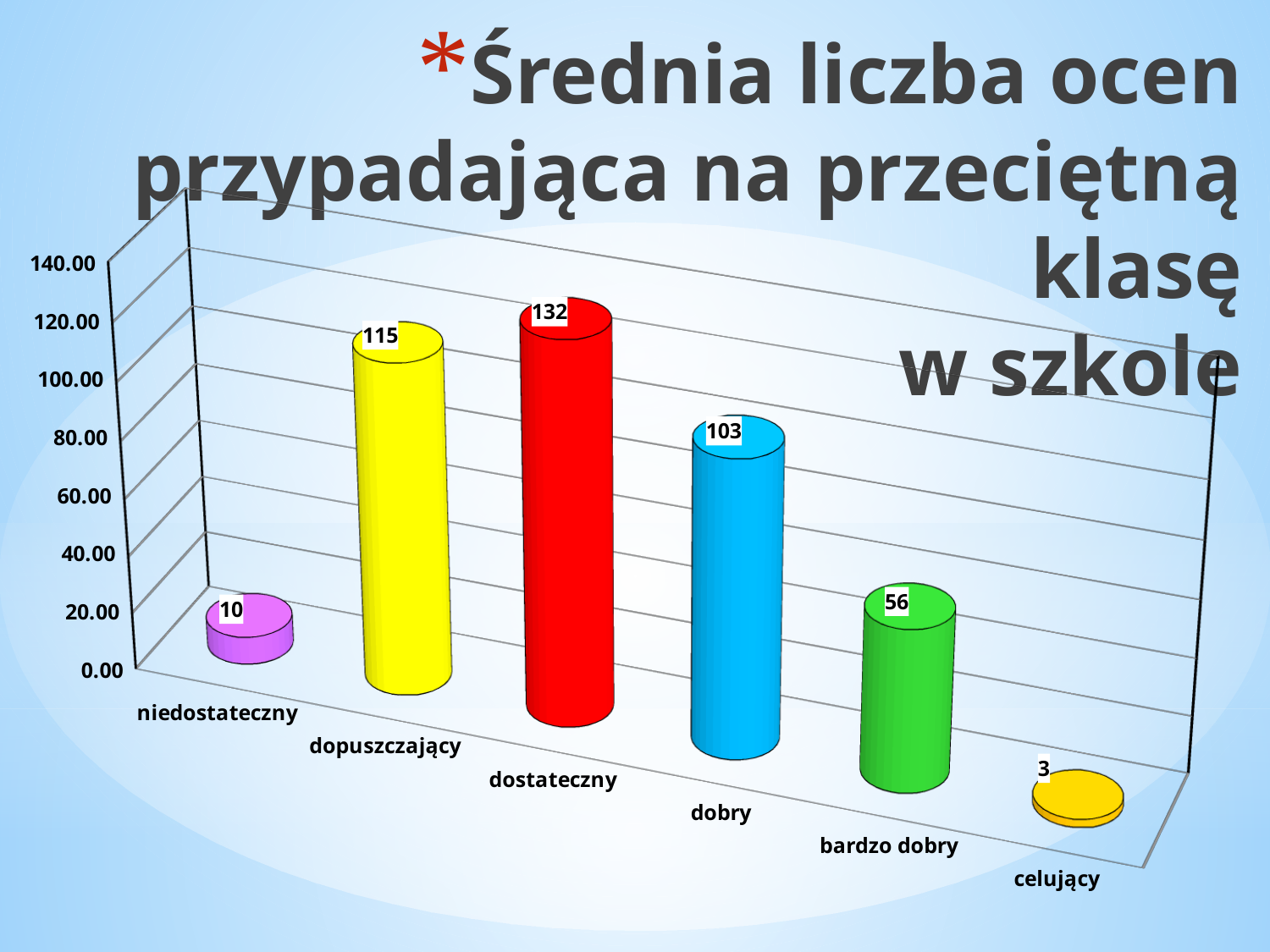
What is the value for niedostateczny? 10 What is the value for bardzo dobry? 56 Which is larger, the value for dopuszczający or the value for dobry? dopuszczający What is the difference between the values for dobry and bardzo dobry? 47 What kind of chart is shown on the slide? bar chart Which category has the highest value? dostateczny What colour is the bar for dostateczny? red What is the difference between the values for dostateczny and dopuszczający? 17 How many categories are shown on the x axis? 6 What is the value for celujący? 3 What is the value for dostateczny? 132 Which category has the lowest value? celujący